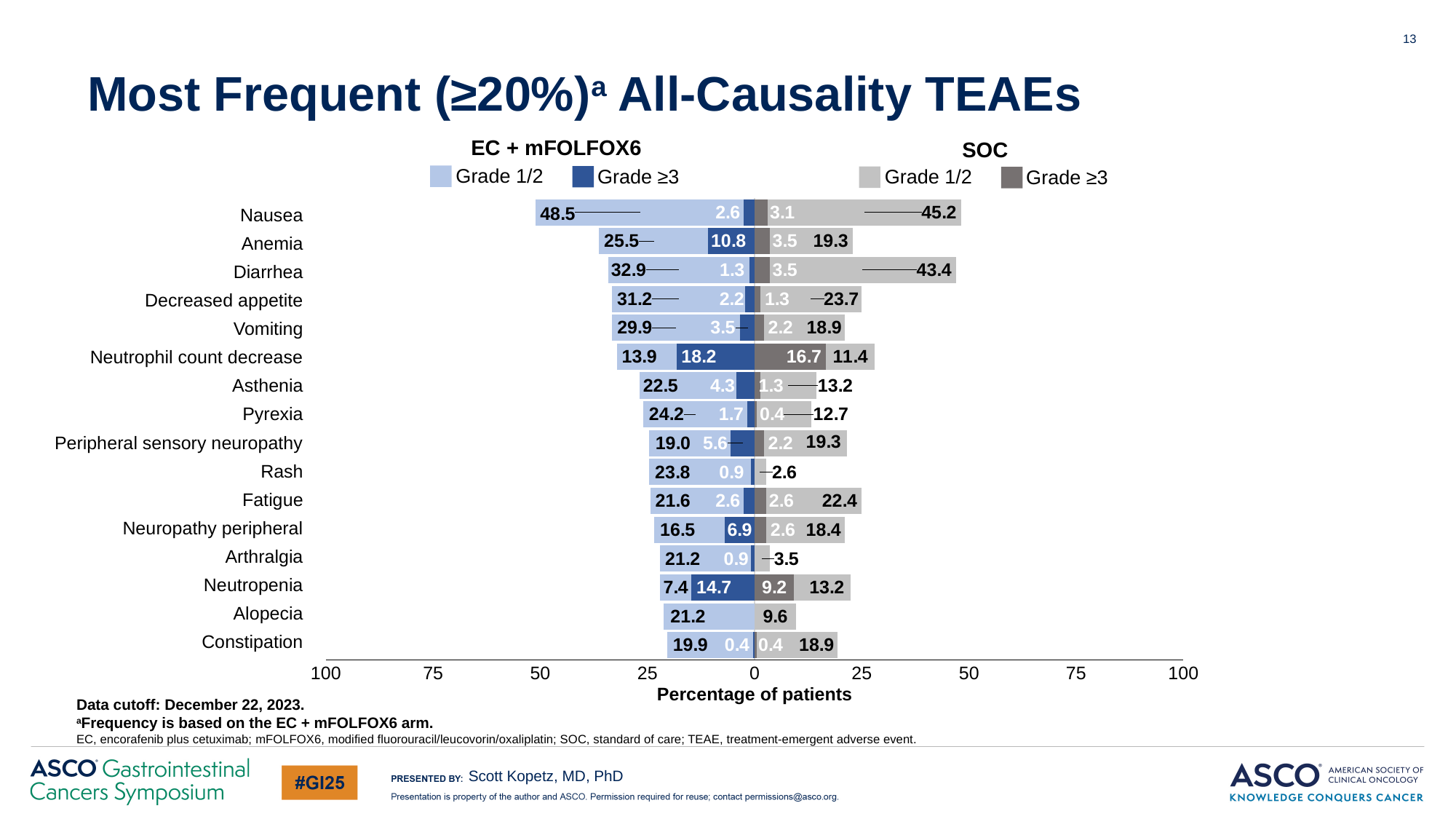
Which adverse event has the highest Grade ≥3 percentage in the EC + mFOLFOX6 arm? Neutrophil count decrease What kind of chart is shown on the slide? Bar chart Is the Grade ≥3 percentage for Anemia higher in the EC + mFOLFOX6 arm or the SOC arm? EC + mFOLFOX6 How many series do the legends list in total? 4 What is the total percentage (Grade 1/2 plus Grade ≥3) for Neutropenia in the EC + mFOLFOX6 arm? 22.1 Which adverse event has the lowest Grade 1/2 percentage in the SOC arm? Rash What is the Grade 1/2 percentage for Diarrhea in the SOC arm? 43.4 What is the difference between the Grade 1/2 percentages for Nausea in the EC + mFOLFOX6 arm and the SOC arm? 3.3 What is the Grade ≥3 percentage for Neutrophil count decrease in the SOC arm? 16.7 How many adverse events are listed on the chart? 16 What is the Grade 1/2 percentage for Nausea in the EC + mFOLFOX6 arm? 48.5 Which adverse event has the highest Grade 1/2 percentage in the EC + mFOLFOX6 arm? Nausea